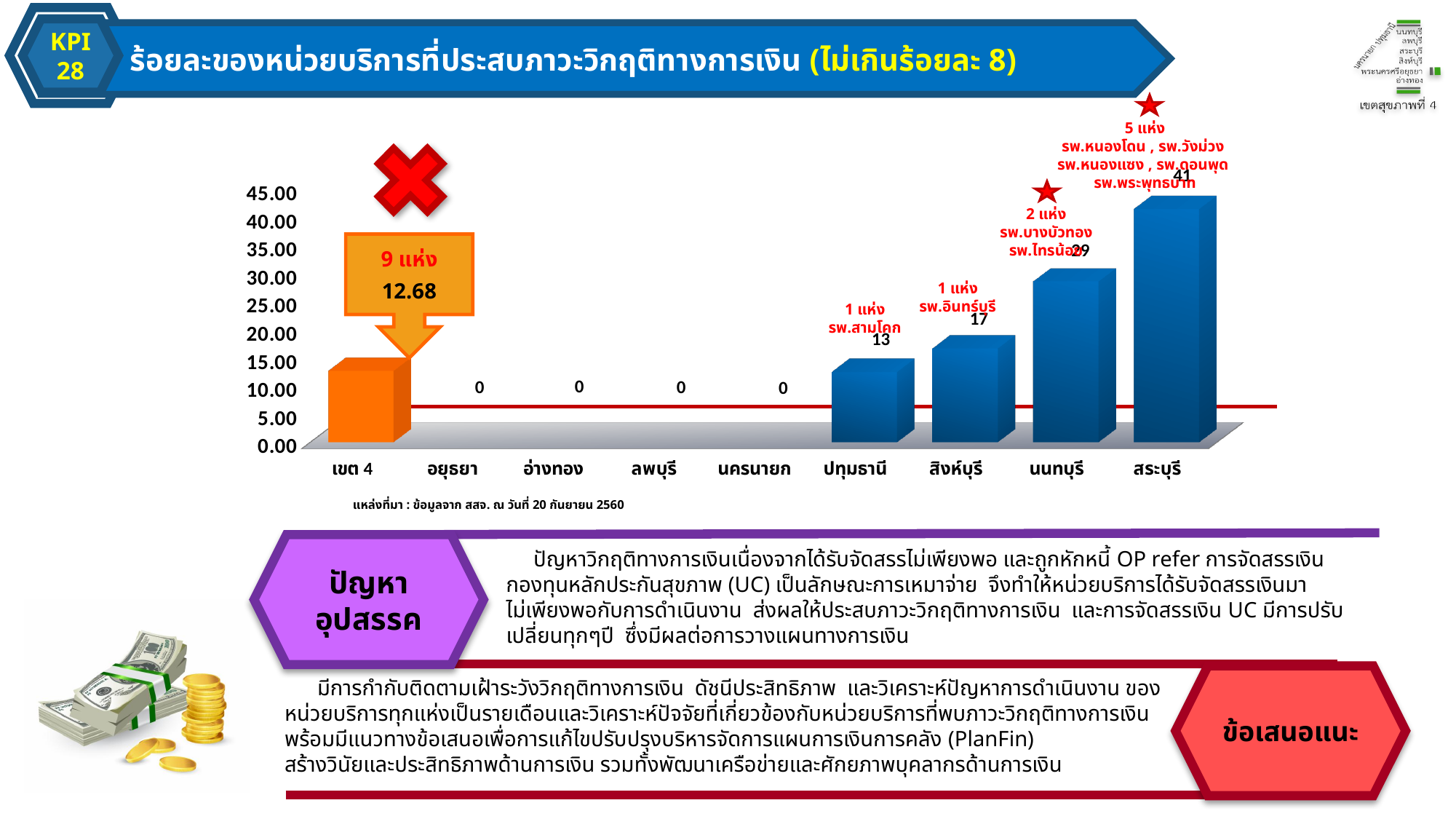
Which is larger, the value for ปทุมธานี or the value for สิงห์บุรี? สิงห์บุรี What is the difference between the values for สระบุรี and สิงห์บุรี? 24 Is the value for นนทบุรี greater or less than 20? greater How many categories have a value of 0? 4 What is the value for ปทุมธานี? 13 What is the value for สิงห์บุรี? 17 What is the value for สระบุรี? 41 How many categories are shown on the x axis? 9 What is the value for อยุธยา? 0 What kind of chart is shown? bar chart Which category has the highest value? สระบุรี What is the value for เขต 4? 12.68